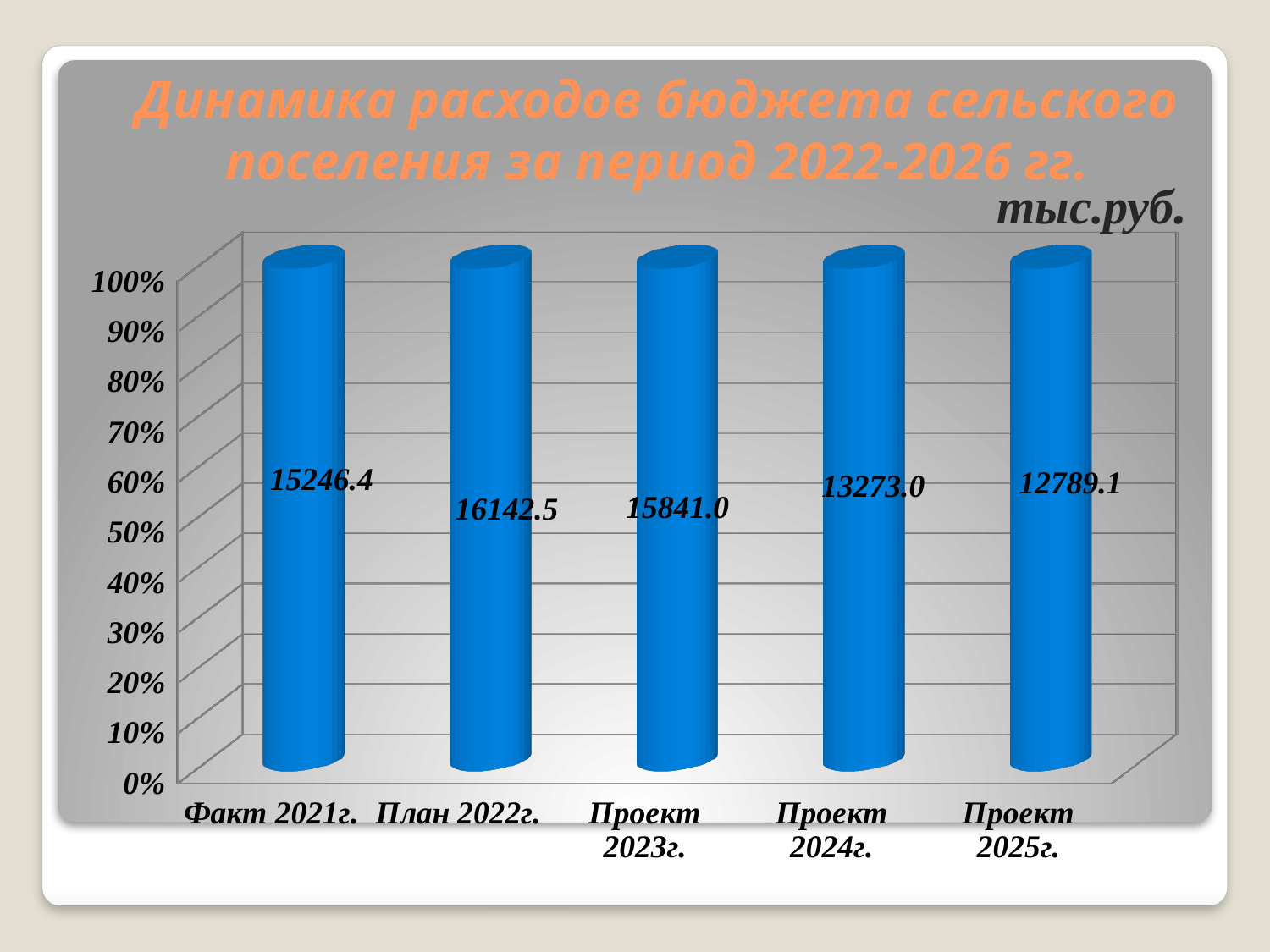
What kind of chart is shown on the slide? Bar chart Which category has the highest labelled value? План 2022г. Which has the larger labelled value, Факт 2021г. or Проект 2023г.? Проект 2023г. Which category has the lowest labelled value? Проект 2025г. How many categories are shown on the x axis? 5 What is the data label for Проект 2025г.? 12789.1 What is the difference between the labelled values for Проект 2024г. and Проект 2025г.? 483.9 What is the data label for Факт 2021г.? 15246.4 What is the data label for План 2022г.? 16142.5 Do the labelled values rise or fall from План 2022г. to Проект 2025г.? Fall What is the difference between the labelled values for План 2022г. and Проект 2023г.? 301.5 What is the data label for Проект 2024г.? 13273.0